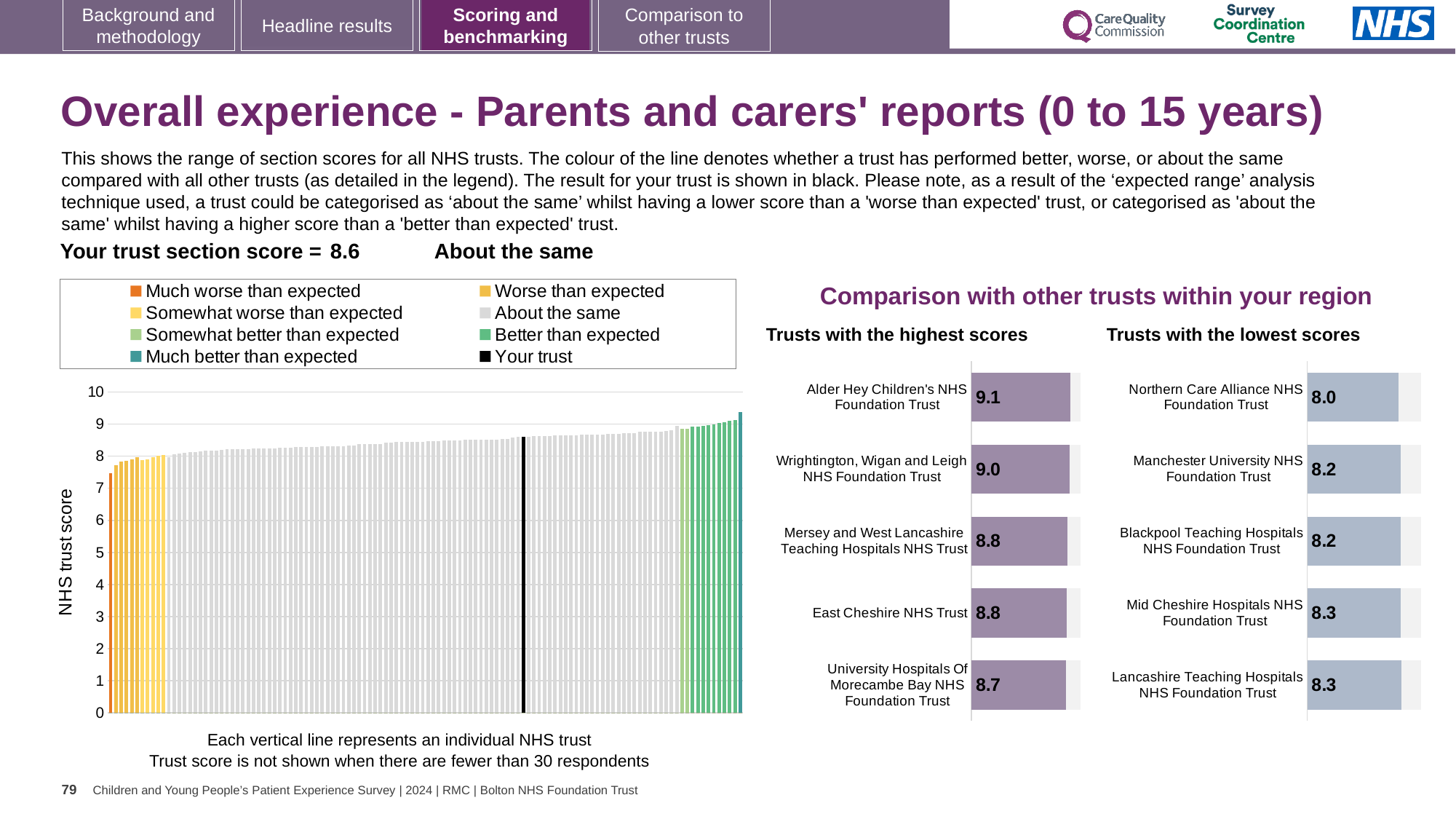
In the 'Trusts with the highest scores' chart, what is the score for University Hospitals Of Morecambe Bay NHS Foundation Trust? 8.7 How many entries does the legend of the NHS trust score chart on the left list? 8 How many trusts are shown in the 'Trusts with the lowest scores' chart? 5 In the 'Trusts with the highest scores' chart, what is the score for Alder Hey Children's NHS Foundation Trust? 9.1 In the 'Trusts with the lowest scores' chart, which trust has the lowest score? Northern Care Alliance NHS Foundation Trust Which is larger: the score for Wrightington, Wigan and Leigh NHS Foundation Trust in the highest scores chart, or the score for Manchester University NHS Foundation Trust in the lowest scores chart? Wrightington, Wigan and Leigh NHS Foundation Trust In the 'Trusts with the lowest scores' chart, what is the score for Mid Cheshire Hospitals NHS Foundation Trust? 8.3 In the 'Trusts with the lowest scores' chart, what is the difference between the scores of Lancashire Teaching Hospitals NHS Foundation Trust and Northern Care Alliance NHS Foundation Trust? 0.3 In the 'Trusts with the highest scores' chart, what is the difference between the scores of Alder Hey Children's NHS Foundation Trust and University Hospitals Of Morecambe Bay NHS Foundation Trust? 0.4 In the NHS trust score chart on the left, is the value of the black 'Your trust' bar greater or less than 8? greater In the 'Trusts with the lowest scores' chart, what is the score for Northern Care Alliance NHS Foundation Trust? 8.0 In the 'Trusts with the highest scores' chart, which trust has the highest score? Alder Hey Children's NHS Foundation Trust